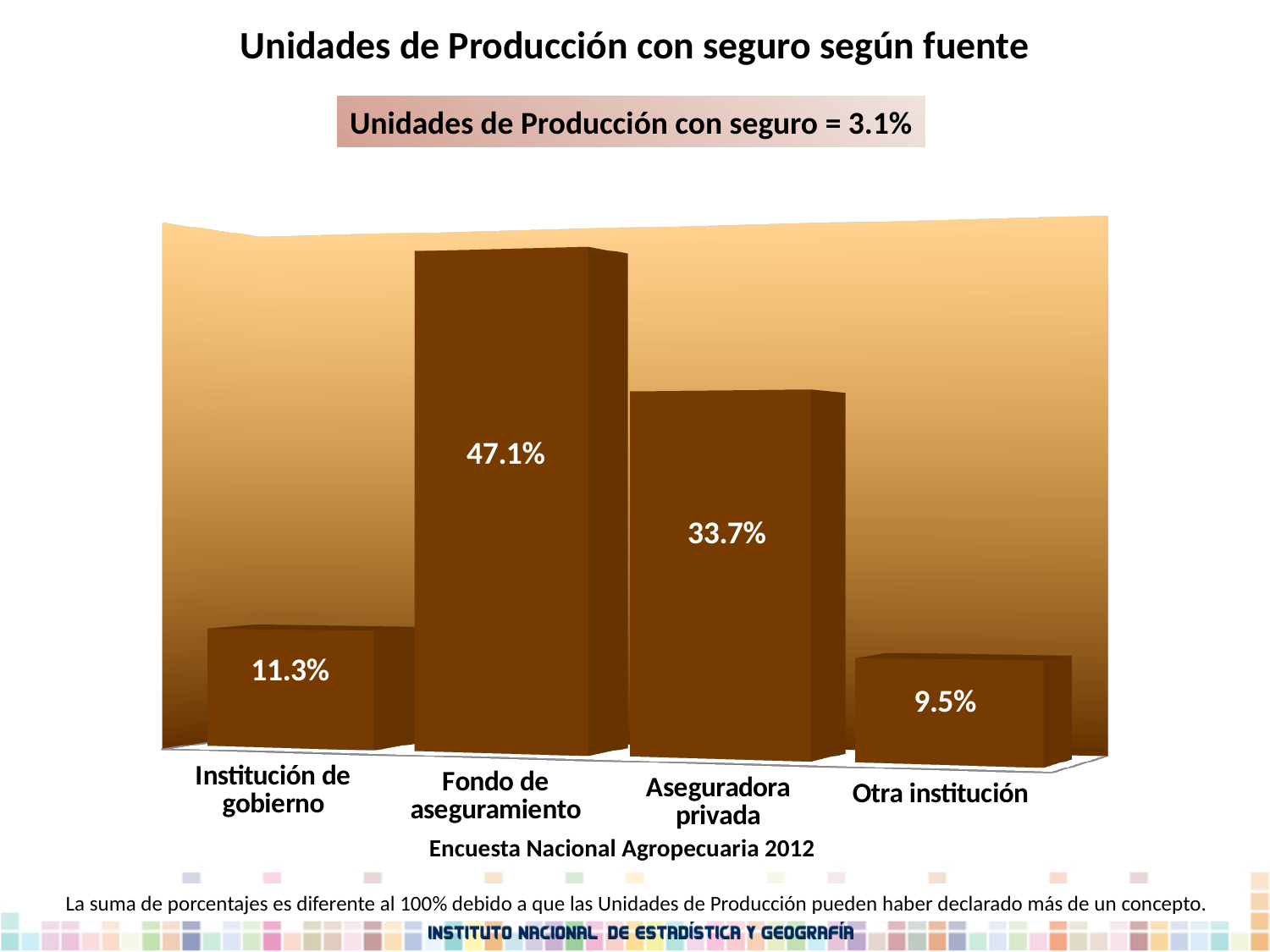
What kind of chart is shown on the slide? Bar chart What is the difference between the values for Institución de gobierno and Otra institución? 1.8% What is the difference between the values for Fondo de aseguramiento and Aseguradora privada? 13.4% Which is larger, the value for Aseguradora privada or the value for Institución de gobierno? Aseguradora privada How many categories are shown in the chart? 4 What is the value for Fondo de aseguramiento? 47.1% What is the title of the chart on the slide? Unidades de Producción con seguro según fuente What is the value for Institución de gobierno? 11.3% Which category has the lowest value? Otra institución What is the value for Aseguradora privada? 33.7% What is the value for Otra institución? 9.5% Which category has the highest value? Fondo de aseguramiento